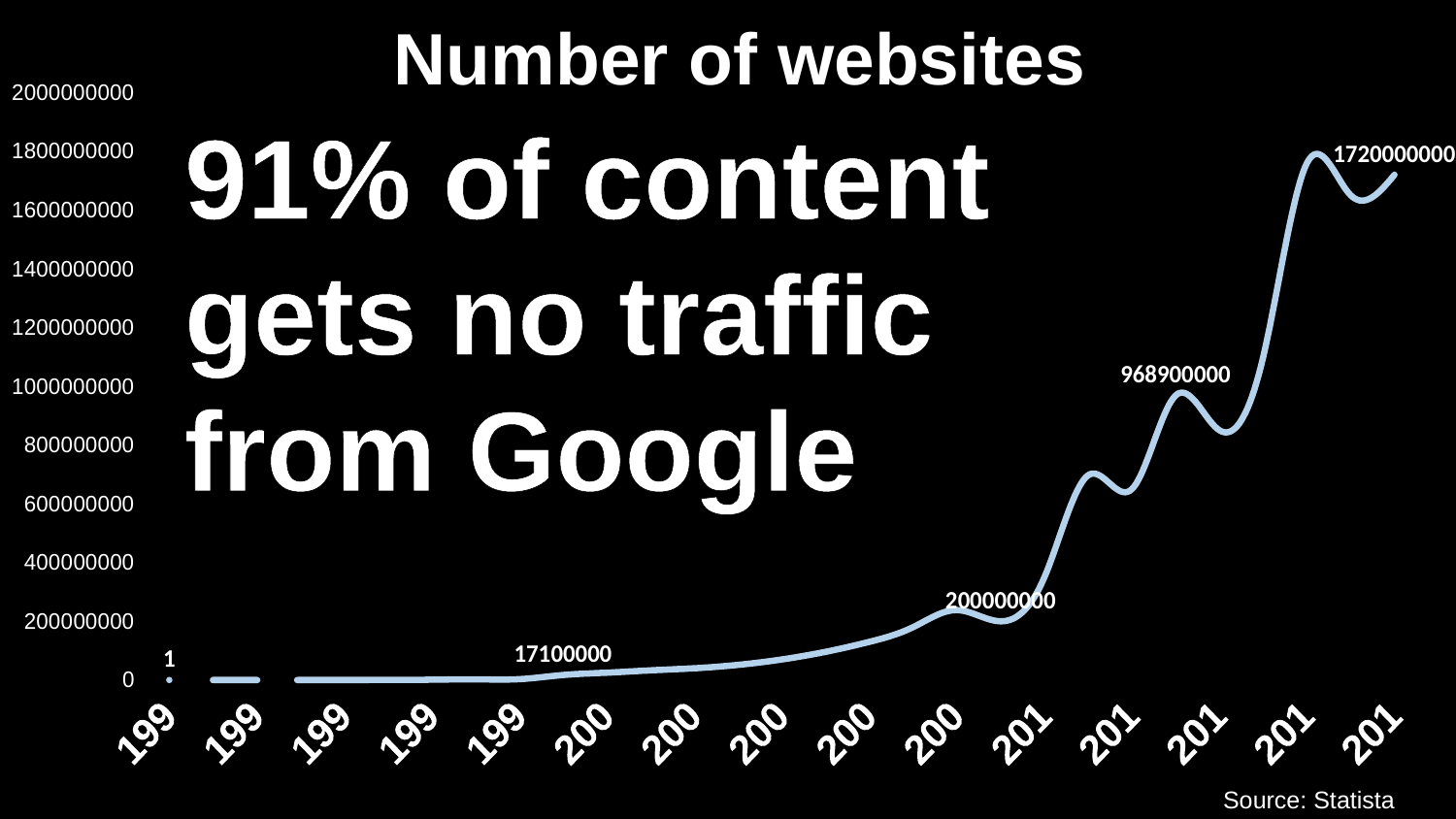
What is the difference between the data labels 1720000000 and 968900000? 751100000 What is the highest data label printed on the chart? 1720000000 How many data labels are printed on the line? 5 What is the difference between the data labels 968900000 and 200000000? 768900000 Is the value at the last point of the line greater or less than 1600000000? greater What is the difference between the data labels 200000000 and 17100000? 182900000 How many category labels are shown along the x axis? 15 What is the title of the chart? Number of websites Do the values generally rise or fall from left to right along the x axis? rise What kind of chart is shown on the slide? line chart What is the lowest data label printed on the chart? 1 What source is cited for the chart data? Statista